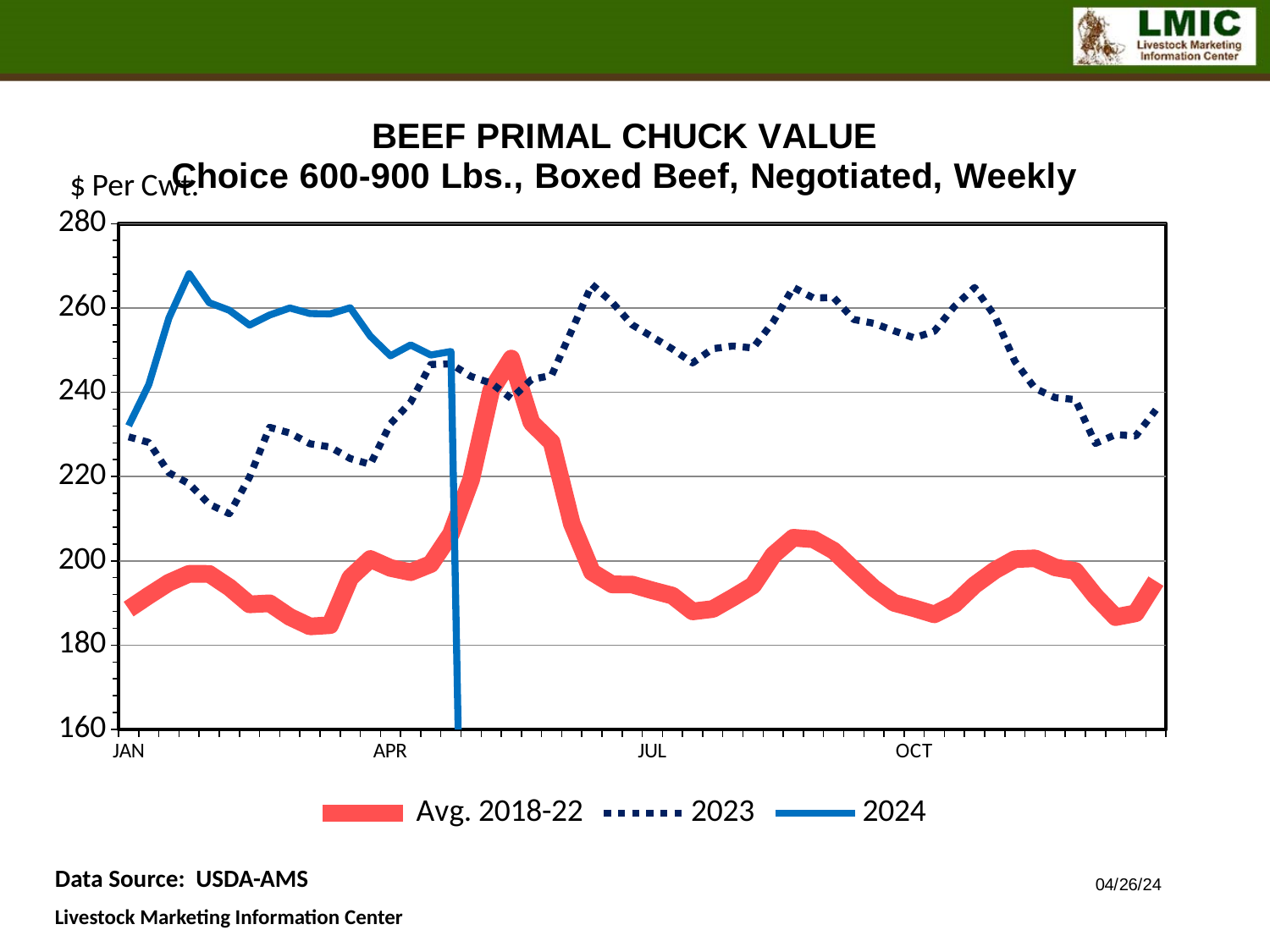
Does the Avg. 2018-22 line rise or fall from APR to its peak in May? rise At JAN, which series has the higher value, 2024 or Avg. 2018-22? 2024 Is the highest point of the 2024 line greater or less than 260? greater How many series does the legend list? 3 What kind of chart is shown on the slide? line chart At APR, which series has the higher value, 2023 or Avg. 2018-22? 2023 What are the three series named in the legend? Avg. 2018-22, 2023, 2024 Is the value of the Avg. 2018-22 line at JAN greater or less than 200? less How many month labels are shown on the x axis? 4 What unit label is shown above the y axis? $ Per Cwt. Is the highest point of the Avg. 2018-22 line greater or less than 260? less